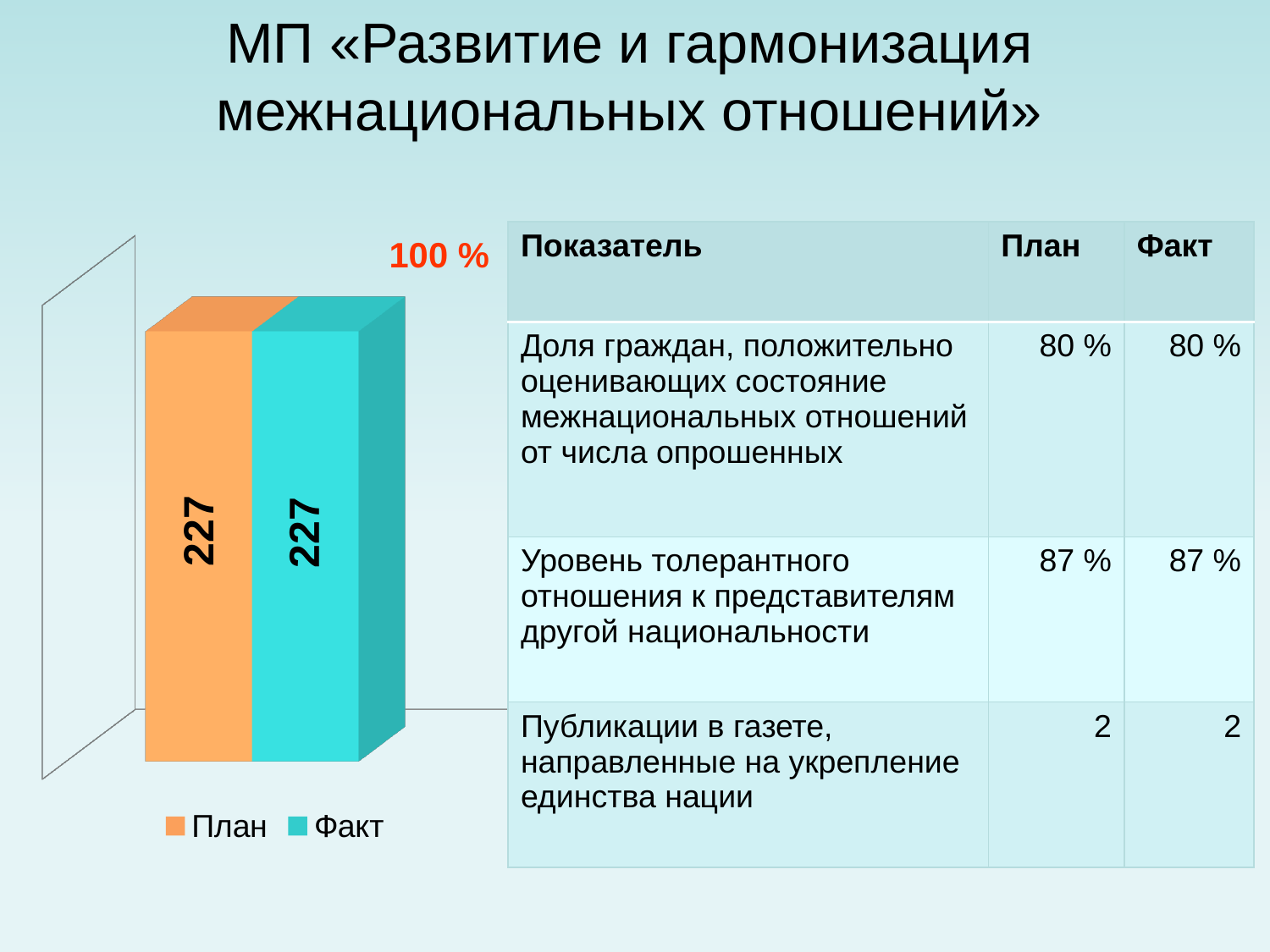
Which legend entry is shown in teal? Факт How many series does the chart legend list? 2 What is the value of the Факт bar in the chart? 227 What is the difference between the План and Факт values in the chart? 0 Which legend entry is shown in orange? План What is the value of the План bar in the chart? 227 What kind of chart is shown on the slide? bar chart Is the value for План greater or less than 200? greater Is the value for Факт greater or less than 100? greater How many bars are plotted in the chart? 2 Are the План and Факт values in the chart equal? Yes